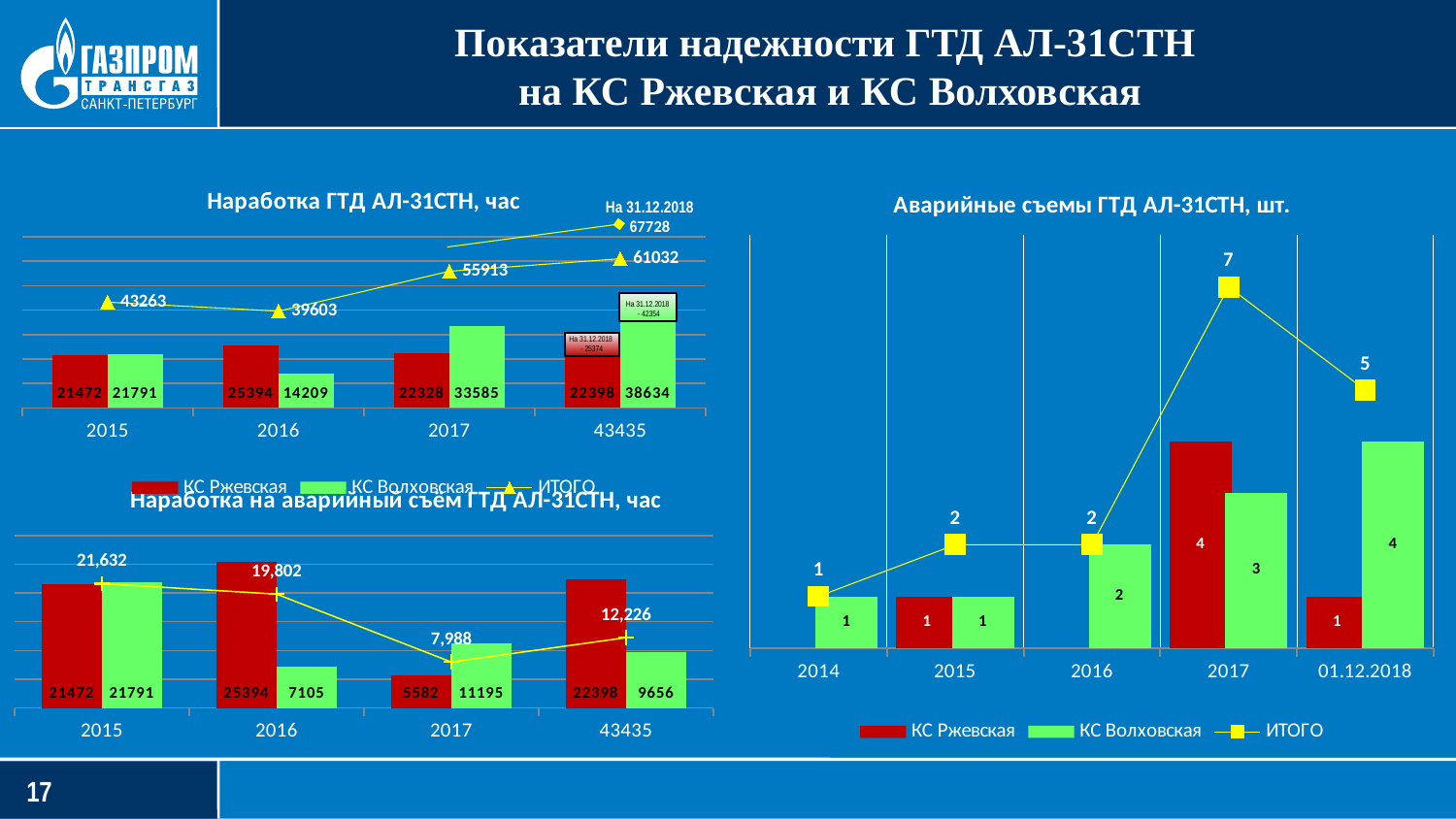
In the chart 'Наработка на аварийный съем ГТД АЛ-31СТН, час', what is the value for КС Ржевская in 2017? 5582 What type of chart is 'Аварийные съемы ГТД АЛ-31СТН, шт.'? Combined bar and line chart In the chart 'Наработка ГТД АЛ-31СТН, час', which of the two stations has the larger value in 2016? КС Ржевская In the chart 'Аварийные съемы ГТД АЛ-31СТН, шт.', how many categories are shown on the x axis? 5 In the chart 'Аварийные съемы ГТД АЛ-31СТН, шт.', what is the value for КС Волховская at 01.12.2018? 4 In the chart 'Наработка ГТД АЛ-31СТН, час', what is the difference between КС Волховская and КС Ржевская in 2017? 11257 In the chart 'Наработка на аварийный съем ГТД АЛ-31СТН, час', what is the ИТОГО value for 2015? 21,632 In the chart 'Наработка ГТД АЛ-31СТН, час', what is the value for КС Волховская in 2017? 33585 In the chart 'Наработка ГТД АЛ-31СТН, час', what is the ИТОГО value for 2016? 39603 In the chart 'Аварийные съемы ГТД АЛ-31СТН, шт.', what is the ИТОГО value for 2017? 7 In the chart 'Наработка на аварийный съем ГТД АЛ-31СТН, час', in which year is the ИТОГО line lowest? 2017 In the chart 'Наработка ГТД АЛ-31СТН, час', how many series does the legend list? 3